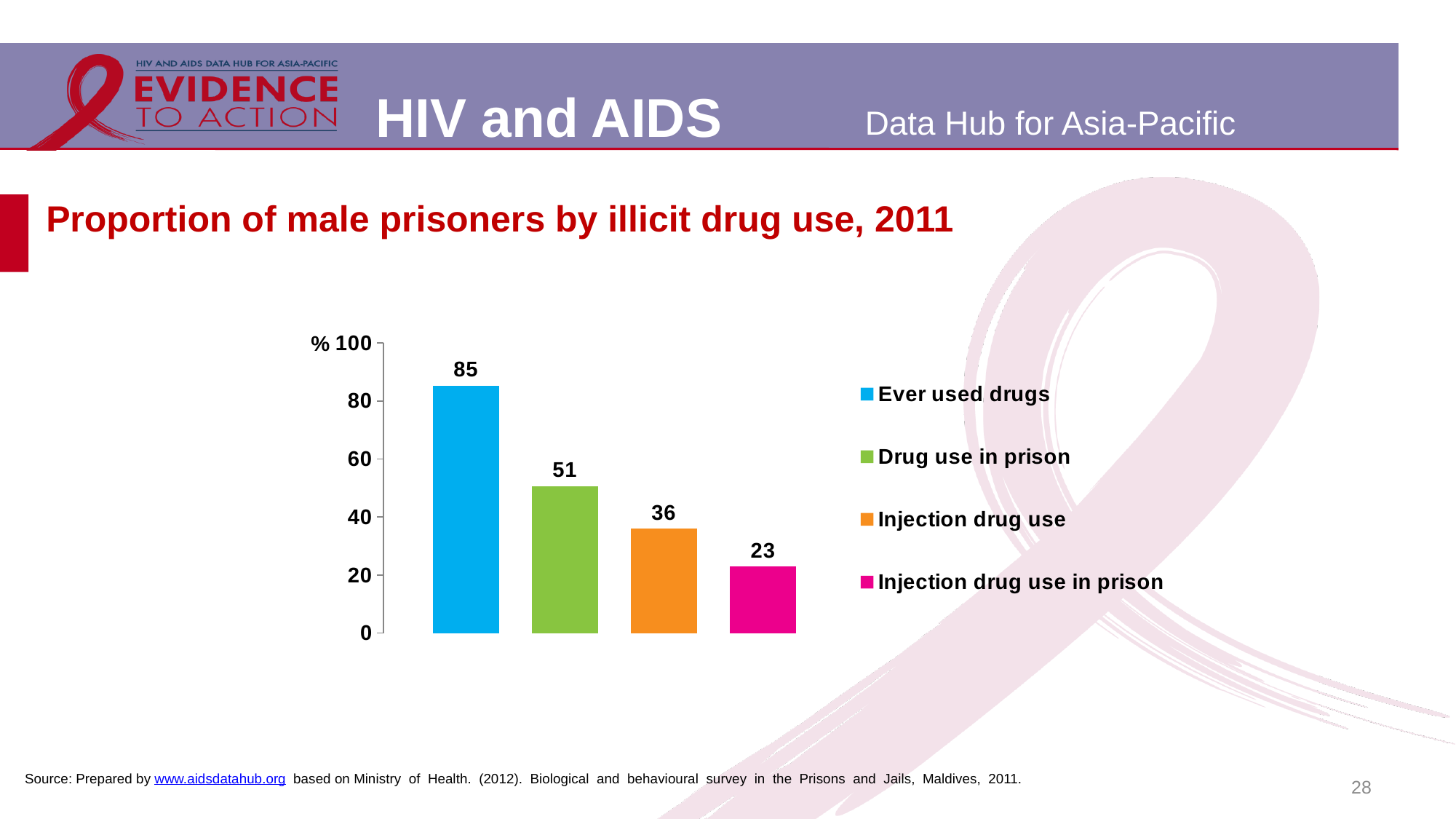
What is the value for Injection drug use? 36 How many bars are shown in the chart? 4 What is the value for Drug use in prison? 51 What is the difference between Ever used drugs and Drug use in prison? 34 What is the value for Injection drug use in prison? 23 What is the value for Ever used drugs? 85 Which category has the highest value? Ever used drugs Which category has the lowest value? Injection drug use in prison What kind of chart is shown on the slide? Bar chart Do the values rise or fall from left to right across the bars? Fall Which is larger, Drug use in prison or Injection drug use? Drug use in prison What is the difference between Injection drug use and Injection drug use in prison? 13